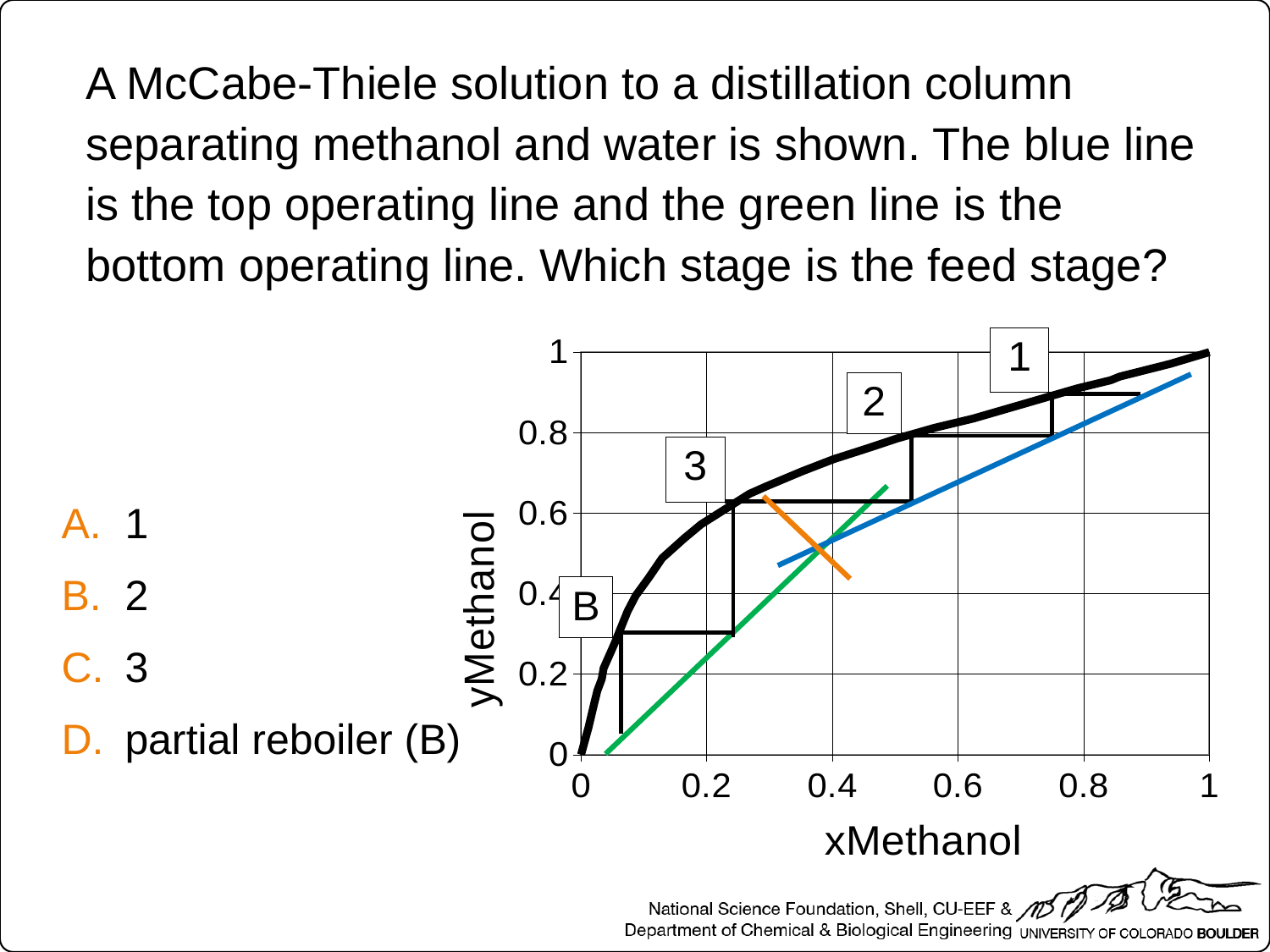
What is the highest tick value shown on the y axis of the chart? 1 How many tick labels are shown on the x axis of the chart? 6 Is the value of the black equilibrium curve at xMethanol = 0.4 greater or less than 0.6? greater What is the label of the x axis of the chart? xMethanol What is the label of the y axis of the chart? yMethanol Does the black equilibrium curve rise or fall as xMethanol increases? rise What kind of chart is shown on the slide? line chart Is the value of the black equilibrium curve at xMethanol = 0.2 greater or less than 0.4? greater How many stage labels (boxed labels) are placed on the chart? 4 At xMethanol = 0.6, which is larger: the black equilibrium curve or the blue top operating line? the black equilibrium curve Is the value of the green bottom operating line at xMethanol = 0.4 greater or less than 0.4? greater